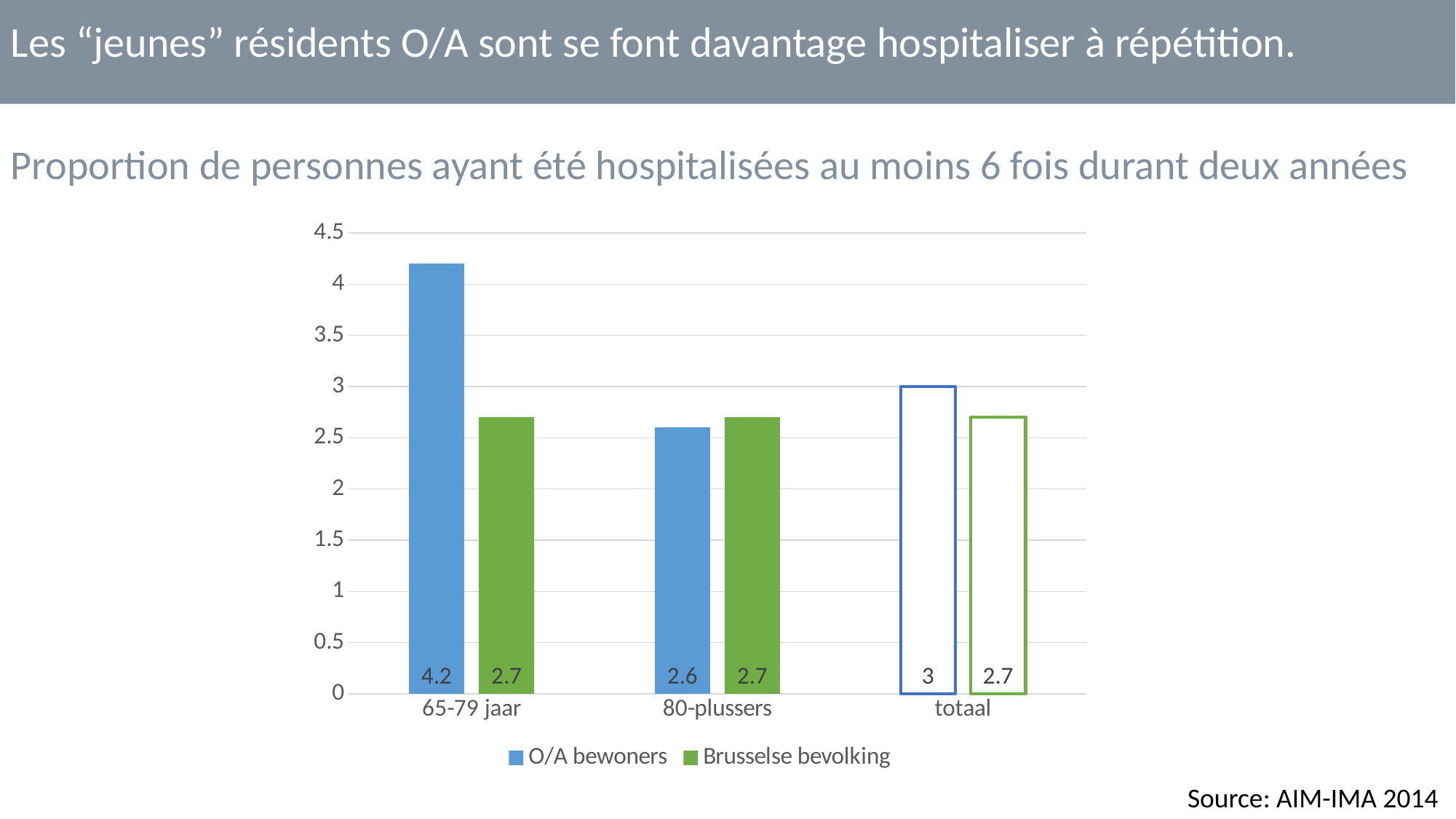
What is the value for O/A bewoners in the 65-79 jaar category? 4.2 Which category has the lowest value for O/A bewoners? 80-plussers Which category has the highest value for O/A bewoners? 65-79 jaar How many categories are shown on the x axis? 3 What is the value for O/A bewoners in the totaal category? 3 In the 80-plussers category, which series has the larger value, O/A bewoners or Brusselse bevolking? Brusselse bevolking How many series does the legend list? 2 Which series is shown in green in the legend? Brusselse bevolking Is the value for O/A bewoners in the 65-79 jaar category greater or less than 4? greater What kind of chart is shown on the slide? bar chart What is the value for Brusselse bevolking in the 80-plussers category? 2.7 What is the difference between the O/A bewoners and Brusselse bevolking values in the 65-79 jaar category? 1.5